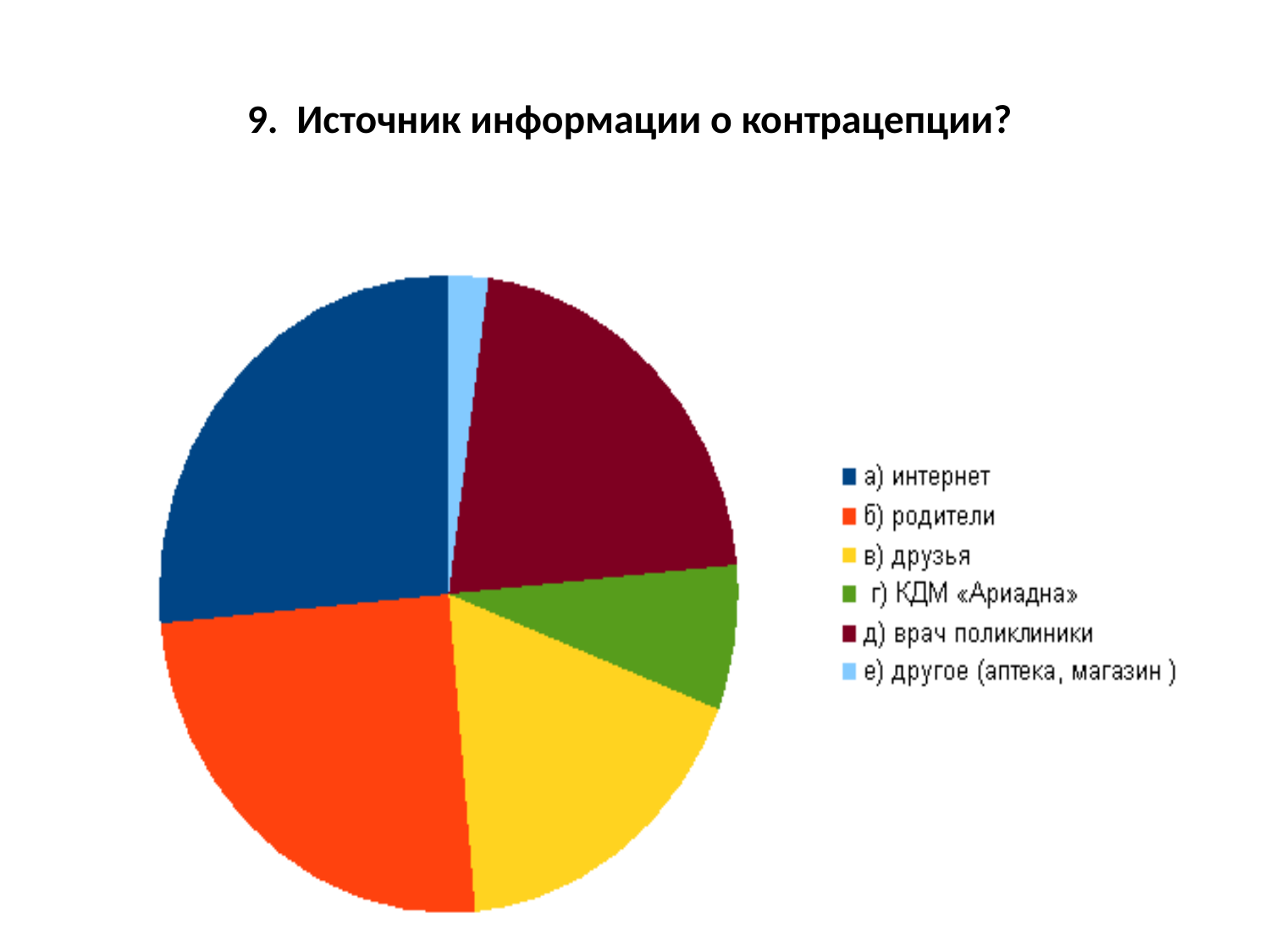
What kind of chart is shown on the slide? pie chart Which slice is larger: в) друзья or г) КДМ «Ариадна»? в) друзья Which slice is larger: д) врач поликлиники or г) КДМ «Ариадна»? д) врач поликлиники How many slices does the pie chart have? 6 Which slice is larger: б) родители or в) друзья? б) родители How many entries does the legend list? 6 What is the title of the chart? 9. Источник информации о контрацепции? Which category is shown in green in the pie chart? г) КДМ «Ариадна» Which category has the smallest slice of the pie? е) другое (аптека, магазин )